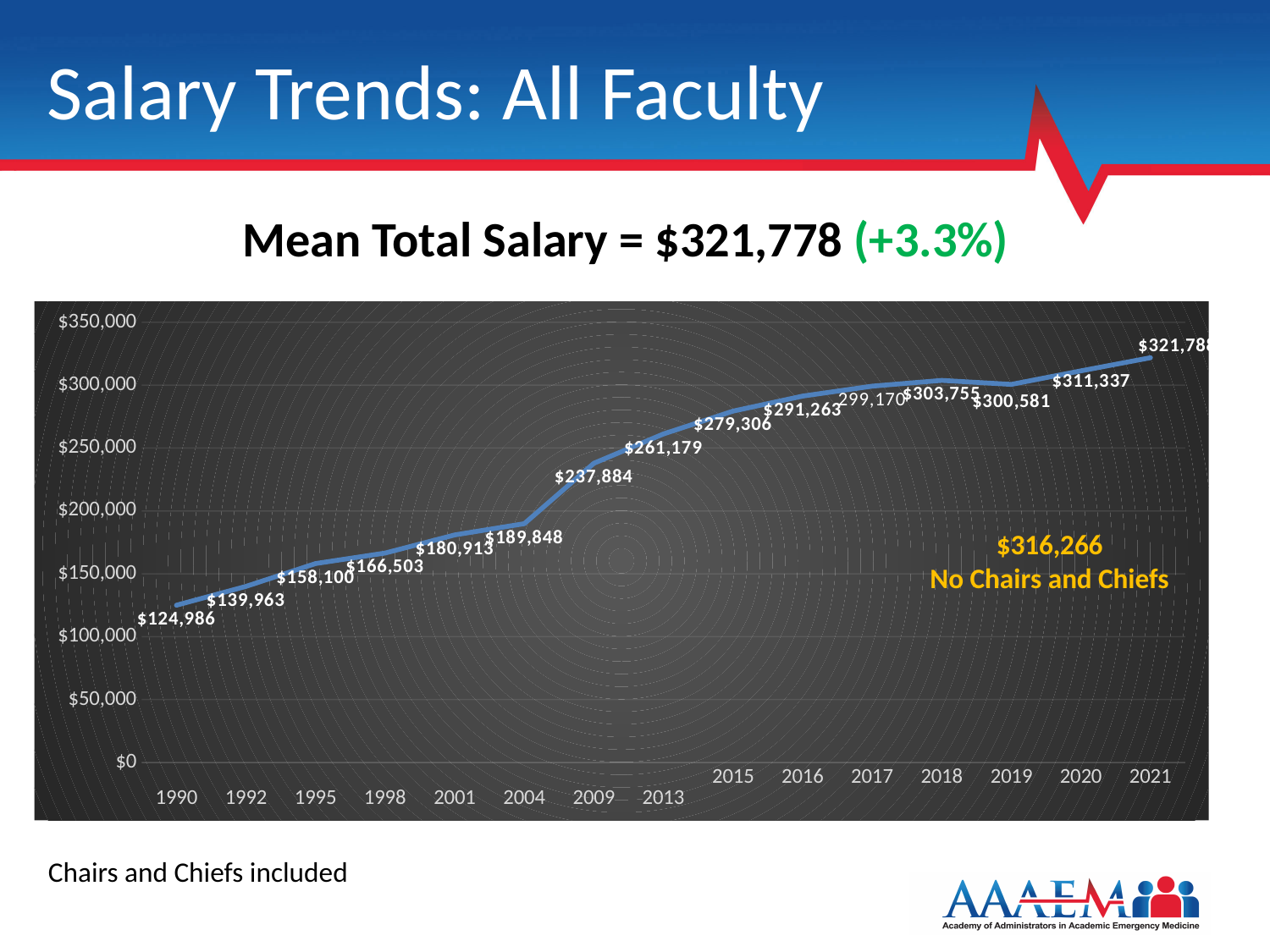
Which year has the highest mean total salary? 2021 Which year has the larger mean total salary, 2018 or 2019? 2018 Is the value for 2004 greater or less than $200,000? less What is the mean total salary for 1990? $124,986 What is the difference between the 2020 and 2019 mean total salaries? $10,756 What kind of chart is shown on the slide? Line chart What is the mean total salary for 2019? $300,581 What is the mean total salary for 2009? $237,884 What is the mean total salary for 2020? $311,337 What is the mean total salary with no chairs and chiefs, as annotated on the chart? $316,266 How many years are plotted on the x axis? 15 Which year has the lowest mean total salary? 1990